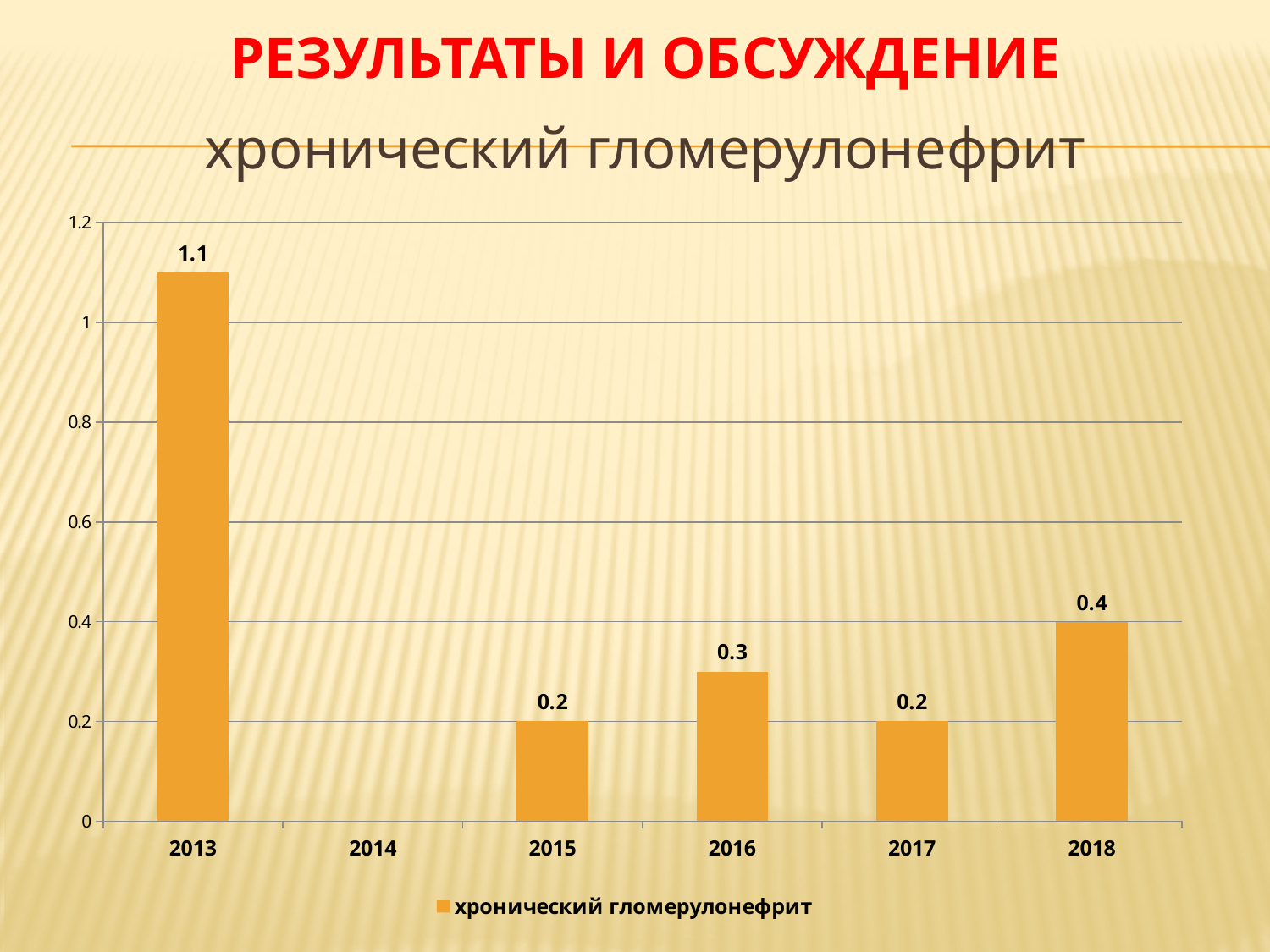
What is the value for 2016? 0.3 What is the value for 2018? 0.4 What is the difference between the values for 2016 and 2015? 0.1 What kind of chart is shown on the slide? bar chart How many years are shown on the x axis? 6 Which year has the highest value? 2013 What is the value for 2017? 0.2 What series name does the legend show? хронический гломерулонефрит What is the value for 2013? 1.1 Which is larger, the value for 2016 or the value for 2017? 2016 Is the value for 2013 greater or less than 1? greater What is the difference between the values for 2013 and 2018? 0.7